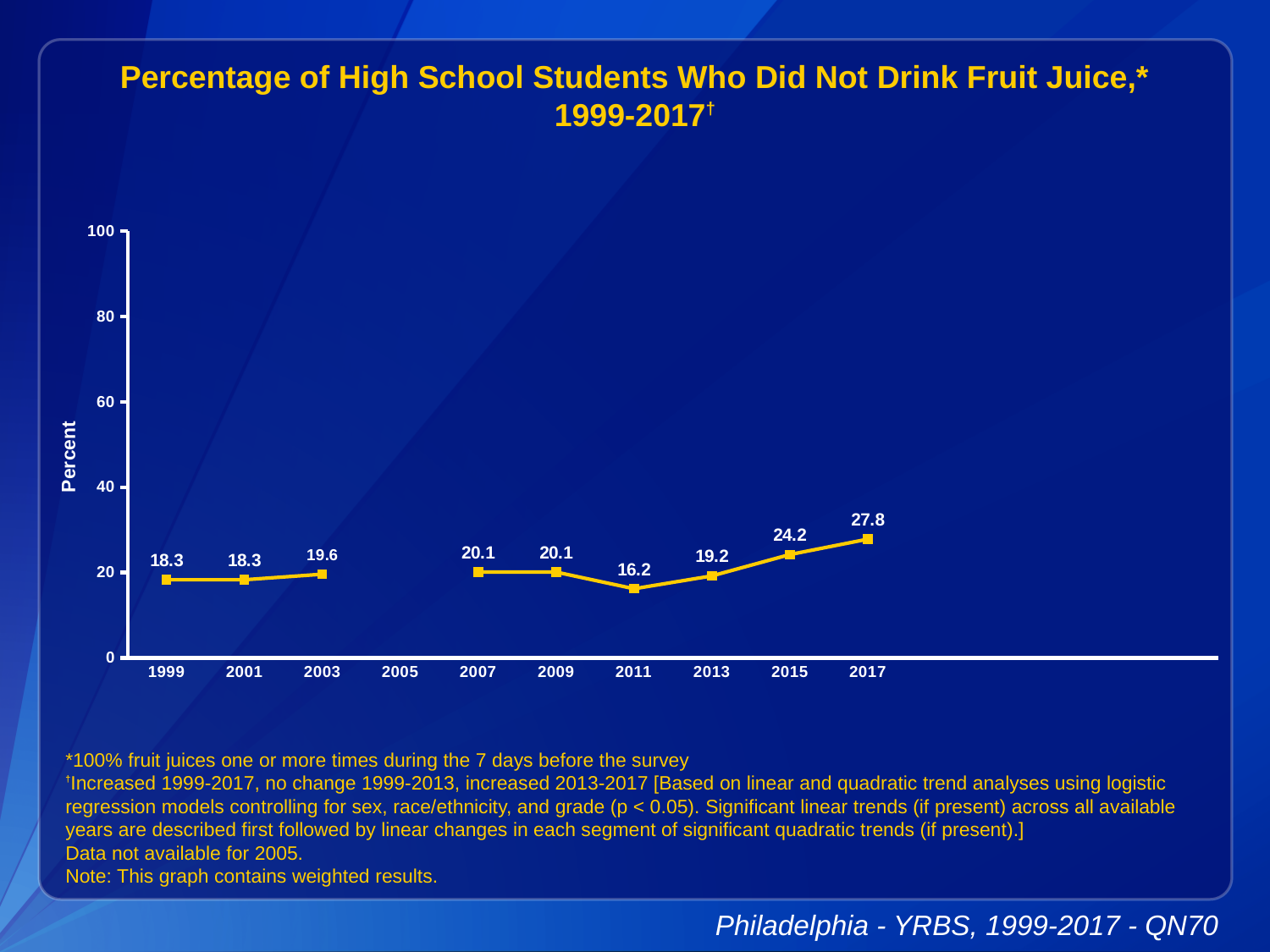
What is the value for 1999? 18.3 Which is larger, the value for 2015 or the value for 2009? 2015 What is the value for 2011? 16.2 Do the values rise or fall from 2013 to 2017? rise Which year has the highest value? 2017 Which year on the x axis has no data point plotted? 2005 Is the value for 2017 greater or less than 40? less What is the value for 2017? 27.8 What kind of chart is shown on the slide? line chart How many years have data points plotted on the chart? 9 What is the difference between the values for 2017 and 2013? 8.6 Which year has the lowest value? 2011